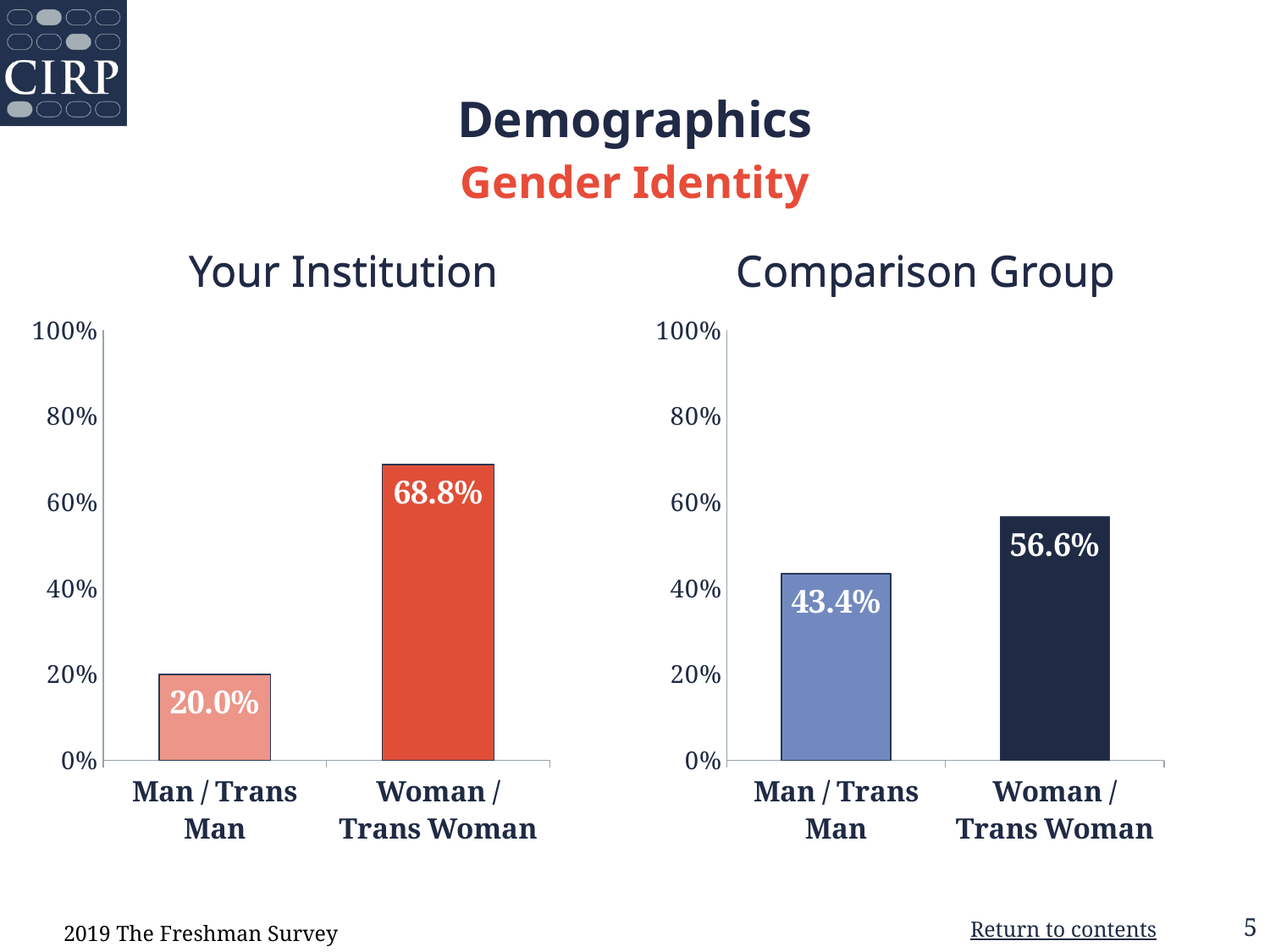
In the 'Comparison Group' chart, what is the difference between the Woman / Trans Woman and Man / Trans Man values? 13.2% In the 'Your Institution' chart, what is the value for Man / Trans Man? 20.0% In the 'Comparison Group' chart, what is the value for Woman / Trans Woman? 56.6% How many categories are shown in the 'Your Institution' chart? 2 In the 'Comparison Group' chart, is the value for Man / Trans Man greater or less than 40%? greater In the 'Your Institution' chart, what is the value for Woman / Trans Woman? 68.8% Which is larger: the Man / Trans Man value in the 'Your Institution' chart or in the 'Comparison Group' chart? Comparison Group In the 'Your Institution' chart, which category has the highest value? Woman / Trans Woman In the 'Comparison Group' chart, what is the value for Man / Trans Man? 43.4% In the 'Comparison Group' chart, which category has the lowest value? Man / Trans Man In the 'Your Institution' chart, what is the difference between the Woman / Trans Woman and Man / Trans Man values? 48.8% What kind of chart is the 'Comparison Group' chart? Bar chart